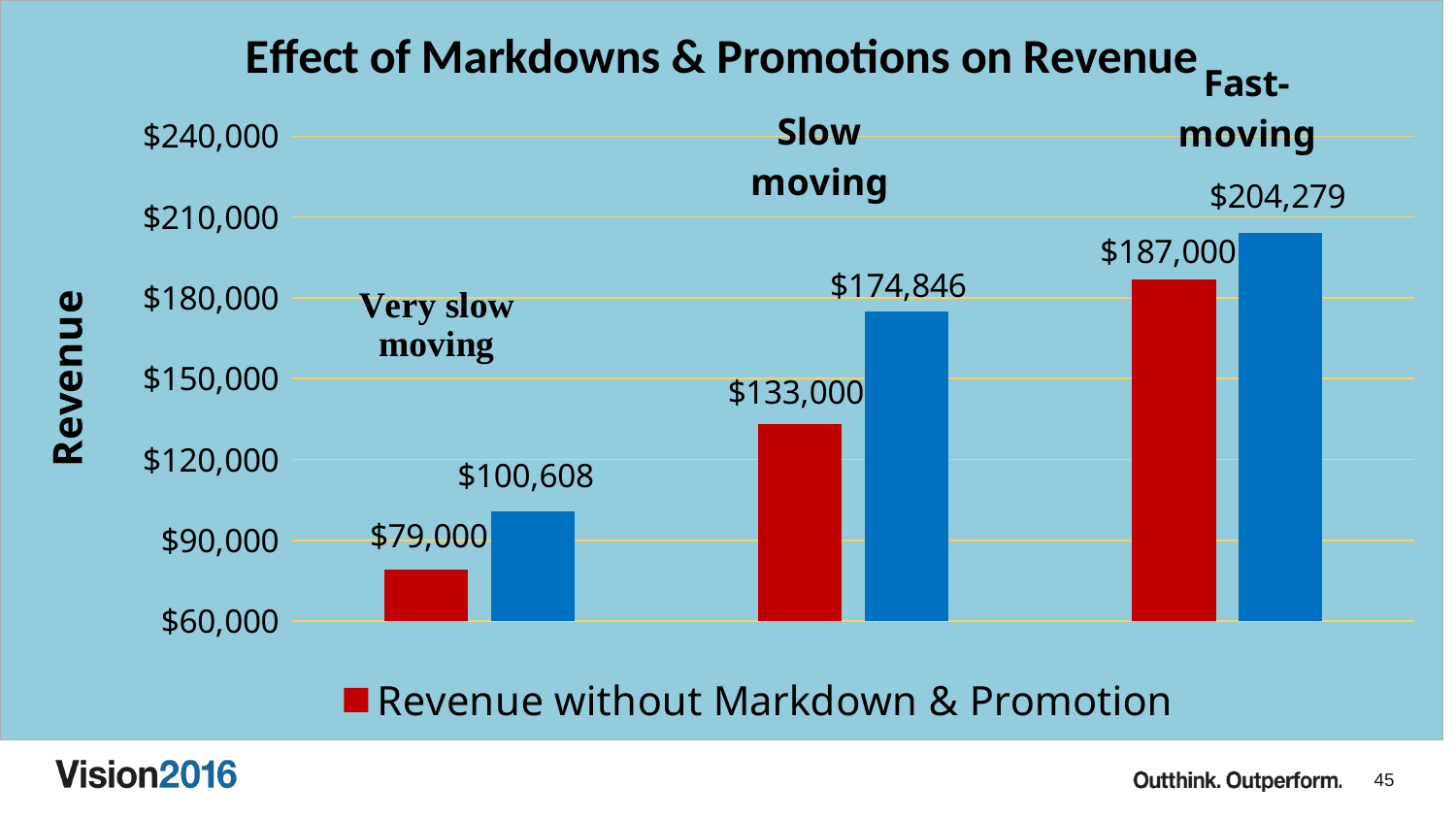
What is the difference between the blue bar ($174,846) and the red bar ($133,000) for the Slow moving category? $41,846 What is the Revenue without Markdown & Promotion for the Fast-moving category? $187,000 Which is larger for the Very slow moving category: the red bar or the blue bar? the blue bar What value is labelled on the blue bar for the Very slow moving category? $100,608 What is the difference in Revenue without Markdown & Promotion between the Fast-moving and Very slow moving categories? $108,000 Which category has the highest Revenue without Markdown & Promotion? Fast-moving How many categories are shown on the x axis? 3 What value is labelled on the blue bar for the Fast-moving category? $204,279 What type of chart is shown on the slide? bar chart Which category has the lowest value on its blue bar? Very slow moving What is the Revenue without Markdown & Promotion for the Slow moving category? $133,000 What is the Revenue without Markdown & Promotion for the Very slow moving category? $79,000